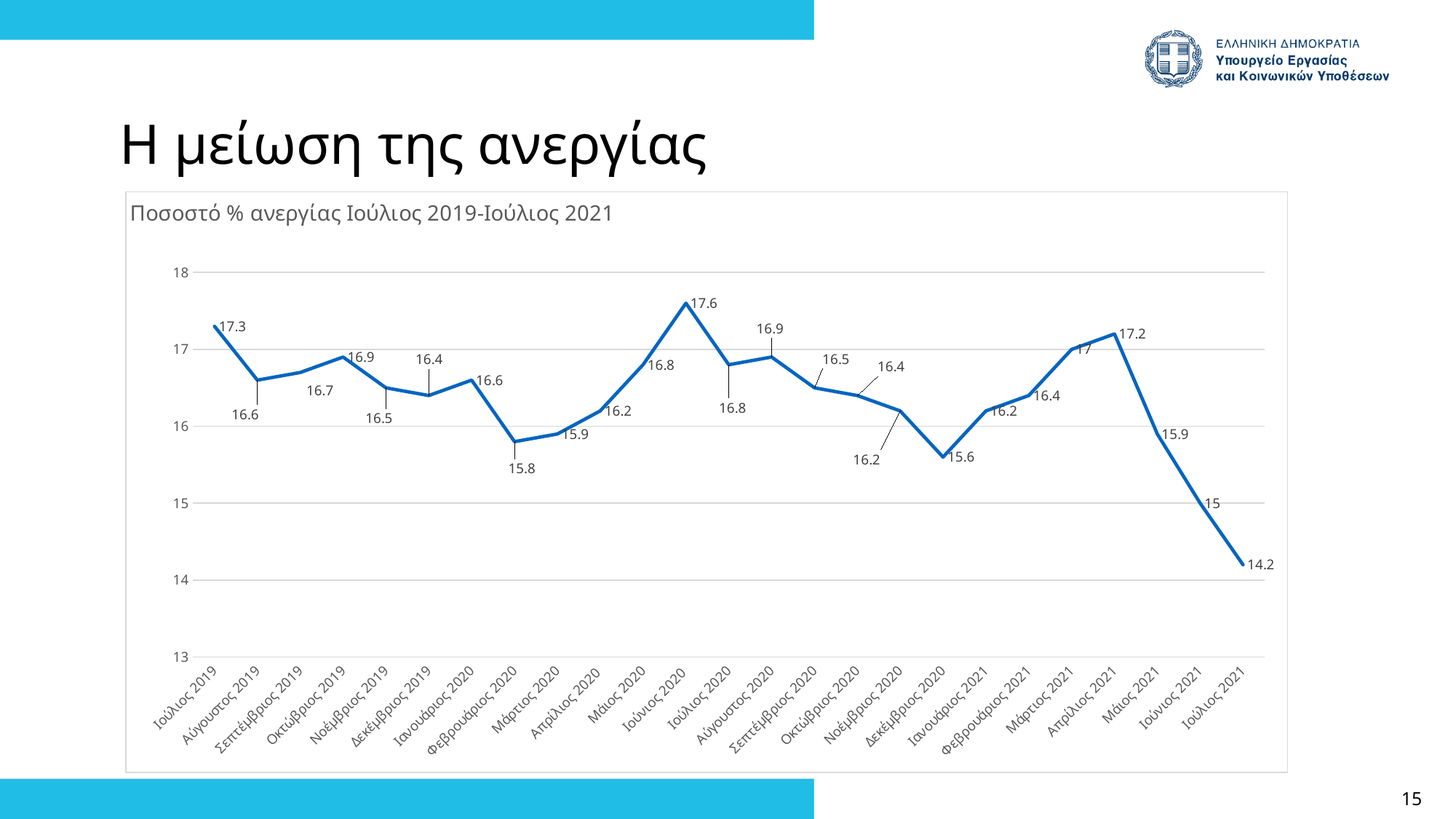
How many monthly data points are plotted on the chart? 25 Which month has the lowest unemployment rate on the chart? Ιούλιος 2021 Is the value for Ιούνιος 2021 greater or less than 16? less What is the unemployment rate shown for Ιούλιος 2019? 17.3 What value is plotted for Δεκέμβριος 2020? 15.6 What value is plotted for Απρίλιος 2021? 17.2 What is the unemployment rate shown for Ιούλιος 2021? 14.2 What is the difference between the unemployment rate in Ιούλιος 2019 and Ιούλιος 2021? 3.1 What kind of chart is shown on the slide? line chart Which is higher, the value for Ιούνιος 2020 or the value for Απρίλιος 2021? Ιούνιος 2020 Which month has the highest unemployment rate on the chart? Ιούνιος 2020 What is the title of the chart? Ποσοστό % ανεργίας Ιούλιος 2019-Ιούλιος 2021